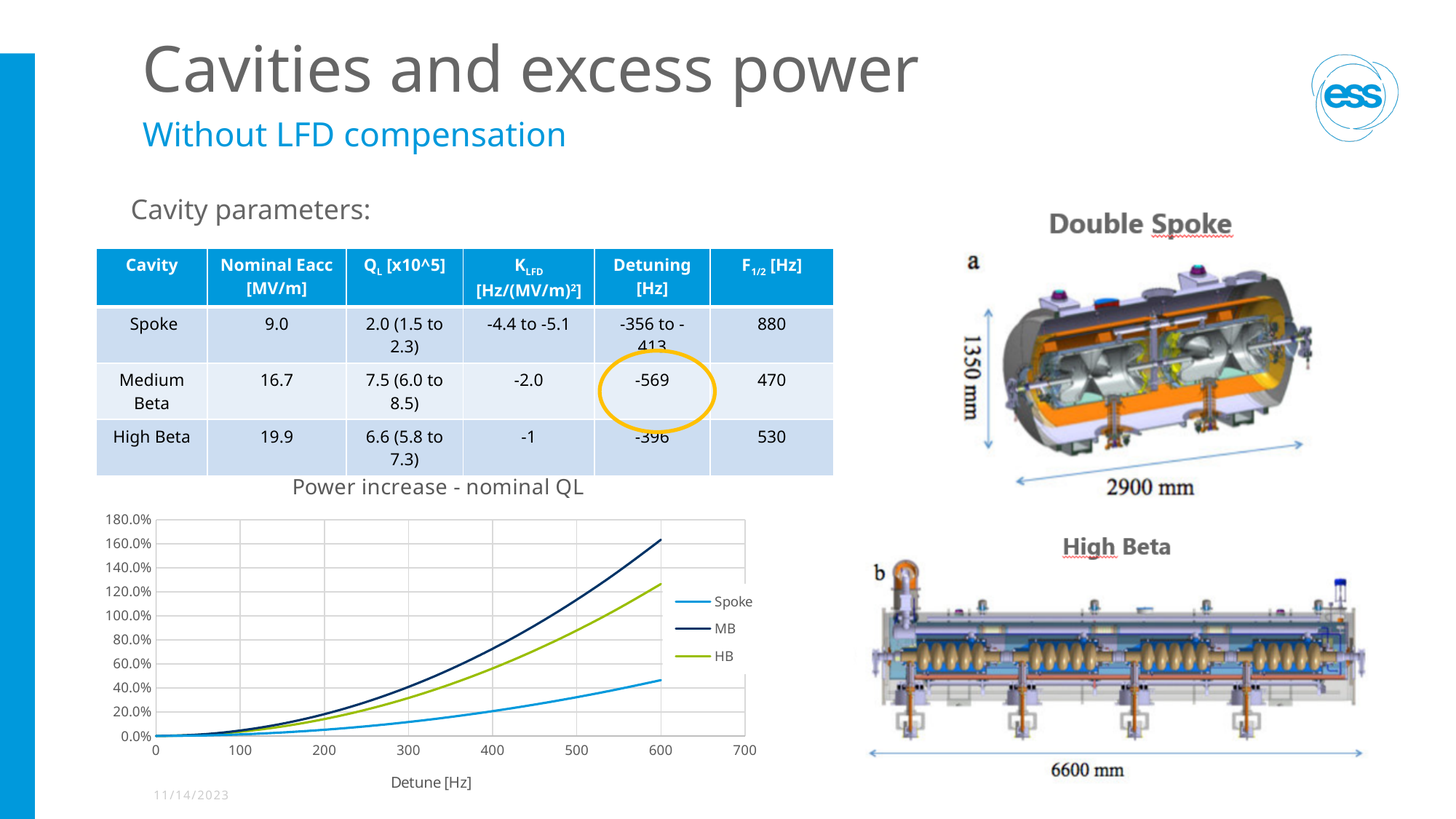
In the 'Power increase - nominal QL' chart, which series has the highest value at 600 Hz detune? MB In the 'Power increase - nominal QL' chart, at 600 Hz detune, is the Spoke value greater or less than 60.0%? less In the 'Power increase - nominal QL' chart, do the values of the MB series rise or fall as detune increases? rise In the 'Power increase - nominal QL' chart, at 600 Hz detune, is the HB value greater or less than 100.0%? greater What is the x-axis label of the 'Power increase - nominal QL' chart? Detune [Hz] In the 'Power increase - nominal QL' chart, at 500 Hz detune, which is larger, the HB value or the Spoke value? HB In the 'Power increase - nominal QL' chart, at 300 Hz detune, is the Spoke value greater or less than 20.0%? less What are the series names in the legend of the 'Power increase - nominal QL' chart? Spoke, MB, HB What kind of chart is the 'Power increase - nominal QL' chart? line chart In the 'Power increase - nominal QL' chart, which series has the lowest value at 600 Hz detune? Spoke How many series does the legend of the 'Power increase - nominal QL' chart list? 3